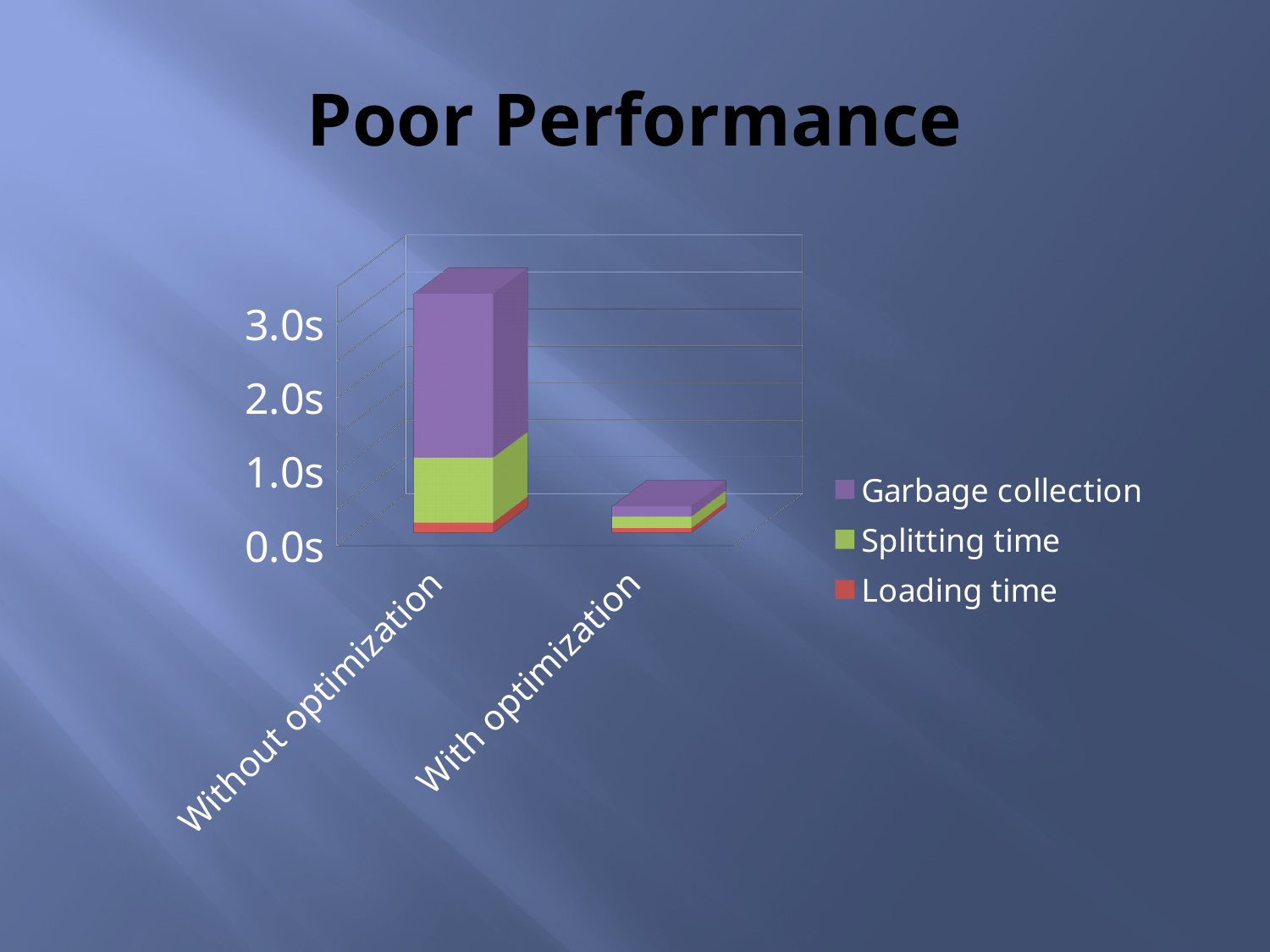
Do the bar totals rise or fall from left to right along the x axis? Fall Is the Garbage collection segment for Without optimization greater or less than 2.0s? greater Which category has the shorter stacked bar? With optimization Which category has the taller stacked bar? Without optimization Is the total height of the With optimization bar greater or less than 1.0s? less Is the Loading time segment for Without optimization greater or less than 1.0s? less What is the title of the slide containing the chart? Poor Performance How many categories are shown on the x axis of the chart? 2 What kind of chart is shown on the slide? Stacked bar chart How many series does the chart's legend list? 3 Which is larger, the Garbage collection segment for Without optimization or for With optimization? Without optimization